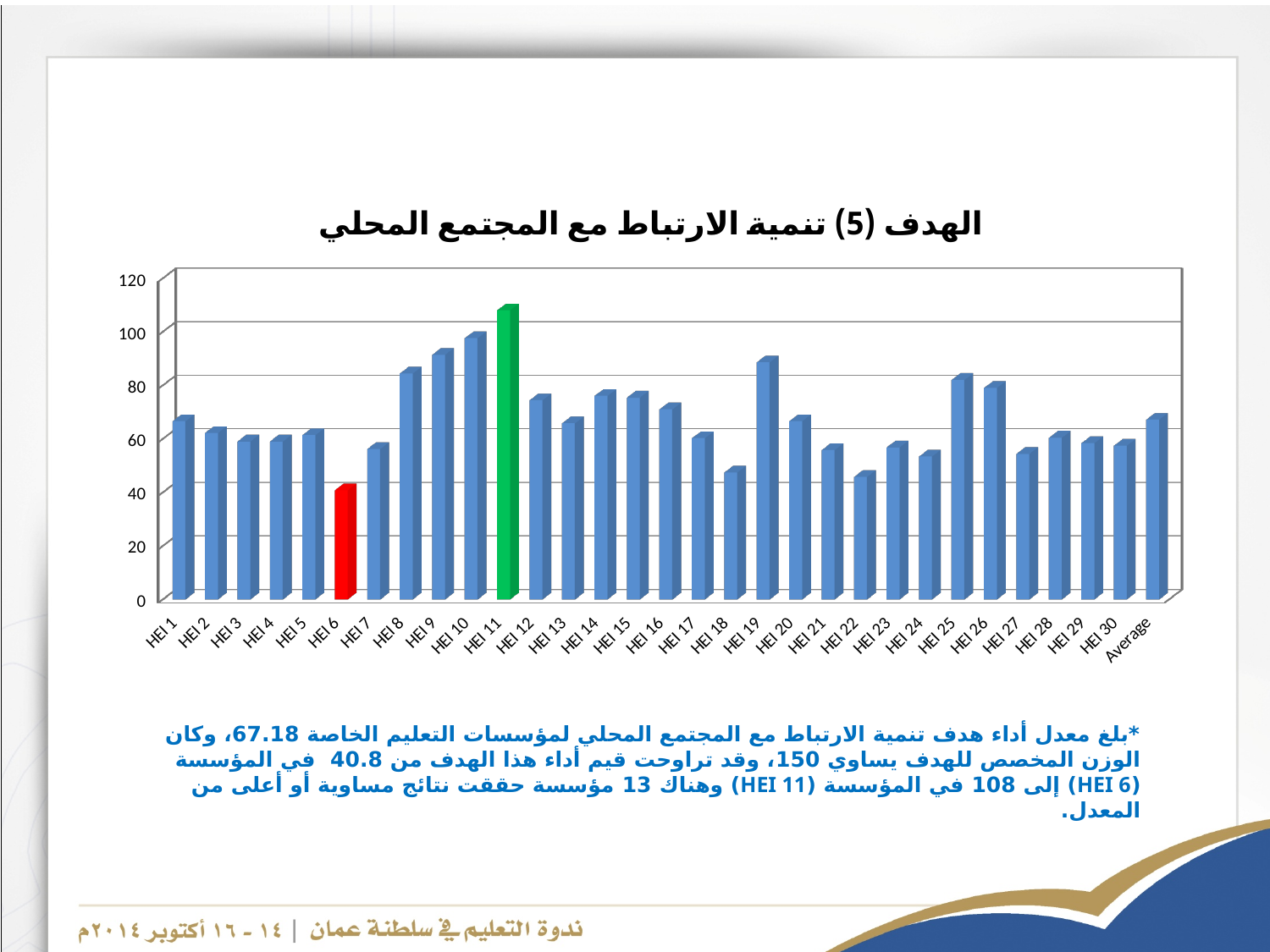
Which is larger, the value for HEI 8 or the value for HEI 7? HEI 8 What colour is the bar for HEI 11? Green Is the value for HEI 10 greater or less than 80? greater What is the value for HEI 11, as stated in the text below the chart? 108 Which institution has the lowest value in the chart? HEI 6 What is the difference between the value for HEI 11 and the value for HEI 6? 67.2 Is the value for HEI 22 greater or less than 60? less Which institution has the highest value in the chart? HEI 11 How many categories are plotted along the x axis of the chart? 31 What is the average value for this goal, as stated in the text below the chart? 67.18 What kind of chart is shown on the slide? Bar chart What is the value for HEI 6, as stated in the text below the chart? 40.8